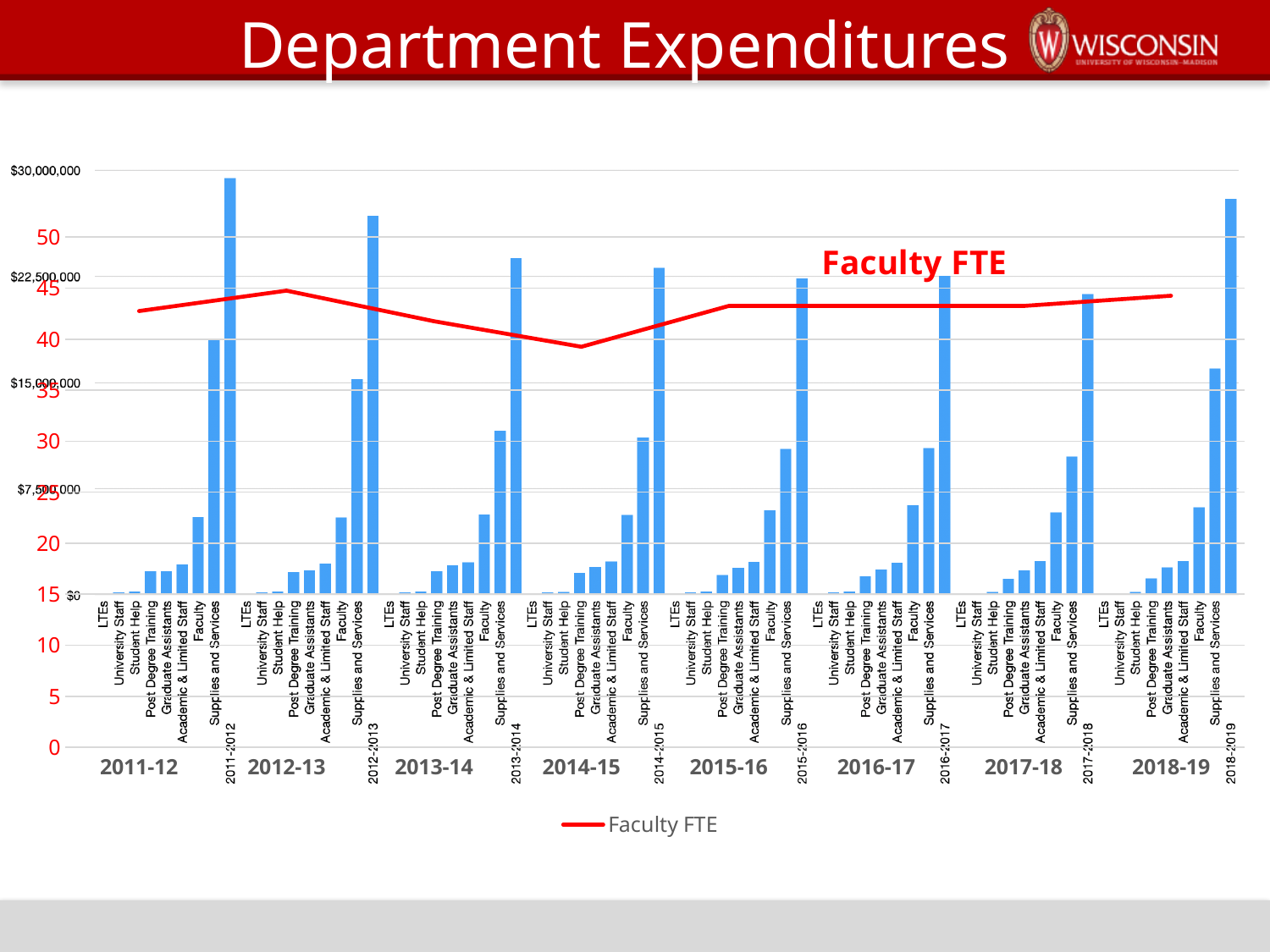
In the expenditures bar chart, is the Faculty value for 2013-2014 greater or less than $15,000,000? less What kind of chart shows the Faculty FTE on this slide? line chart In the Faculty FTE line chart, is the value for 2014-15 greater or less than 40? less In the expenditures bar chart, is the Faculty value for 2011-2012 greater or less than $15,000,000? less In the Faculty FTE line chart, does the Faculty FTE rise or fall from 2014-15 to 2018-19? rise How many series does the legend at the bottom of the slide list? 1 In the Faculty FTE line chart, which year has the lowest Faculty FTE? 2014-15 What kind of chart shows the department expenditures by category on this slide? bar chart In the expenditures bar chart, which category has the tallest bar in 2011-2012? Supplies and Services